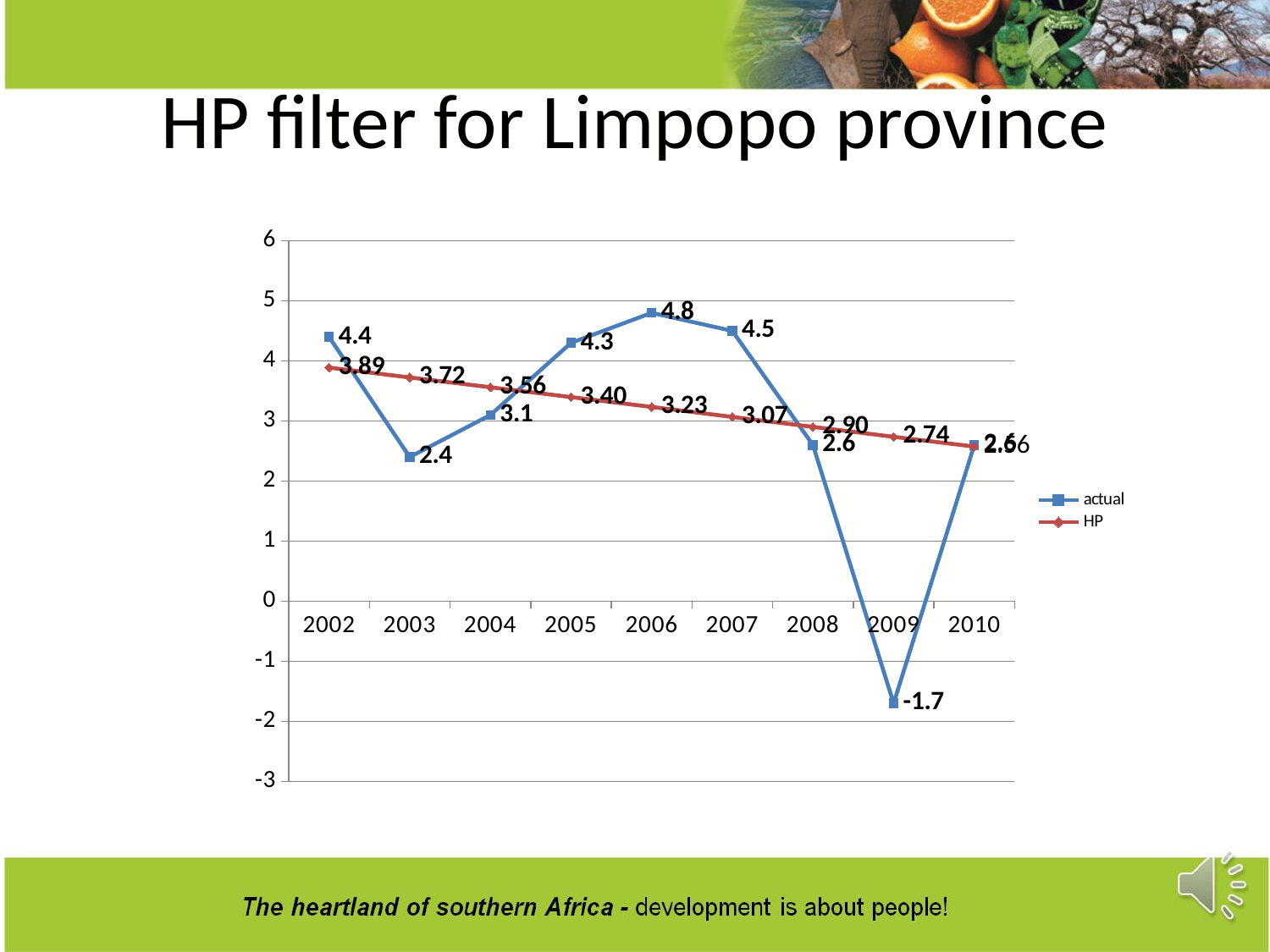
What type of chart is shown on the slide? line chart How many series does the legend list? 2 How many years are shown on the x axis? 9 Which is larger in 2005, the actual value or the HP value? actual Does the HP series rise or fall from 2002 to 2010? fall In which year is the actual series at its lowest? 2009 What is the actual value for 2006? 4.8 What is the difference between the actual value for 2006 and the actual value for 2003? 2.4 What is the HP value for 2007? 3.07 In which year is the actual series at its highest? 2006 What is the HP value for 2004? 3.56 What is the actual value for 2009? -1.7